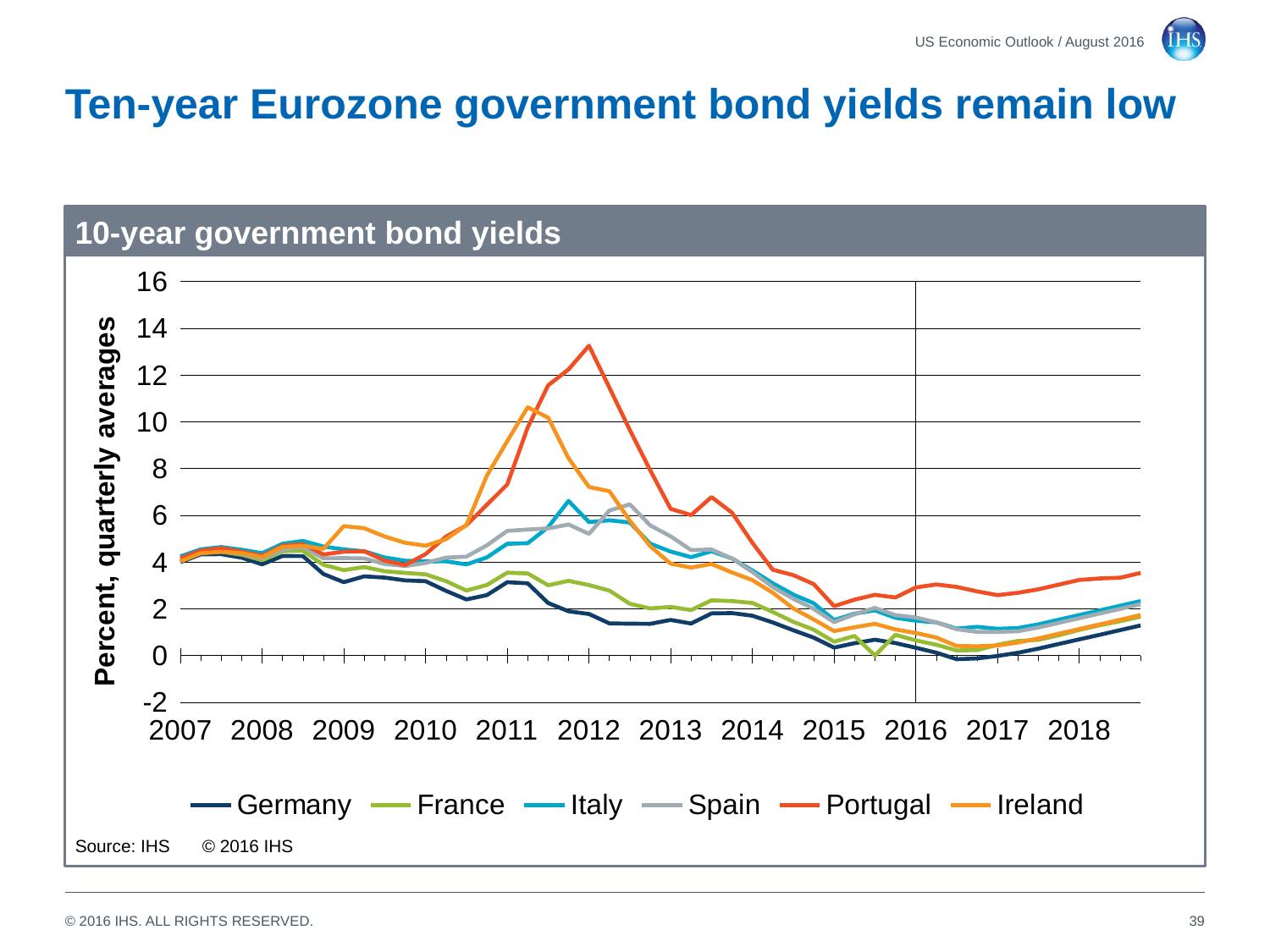
Is the peak value for Ireland greater or less than 8? greater Which country's bond yield reaches the highest peak on the chart? Portugal Which country has the lowest bond yield around 2017? Germany What is the title of the chart? 10-year government bond yields Does Portugal's bond yield rise or fall between 2012 and 2015? fall What is the label on the vertical axis of the chart? Percent, quarterly averages In 2011, which is higher: the yield for Ireland or the yield for Spain? Ireland In 2012, which is higher: the yield for Portugal or the yield for Germany? Portugal What kind of chart is shown on the slide? line chart How many series does the legend list? 6 Is the peak value for Portugal greater or less than 12? greater Is the value for Germany in 2017 greater or less than 2? less